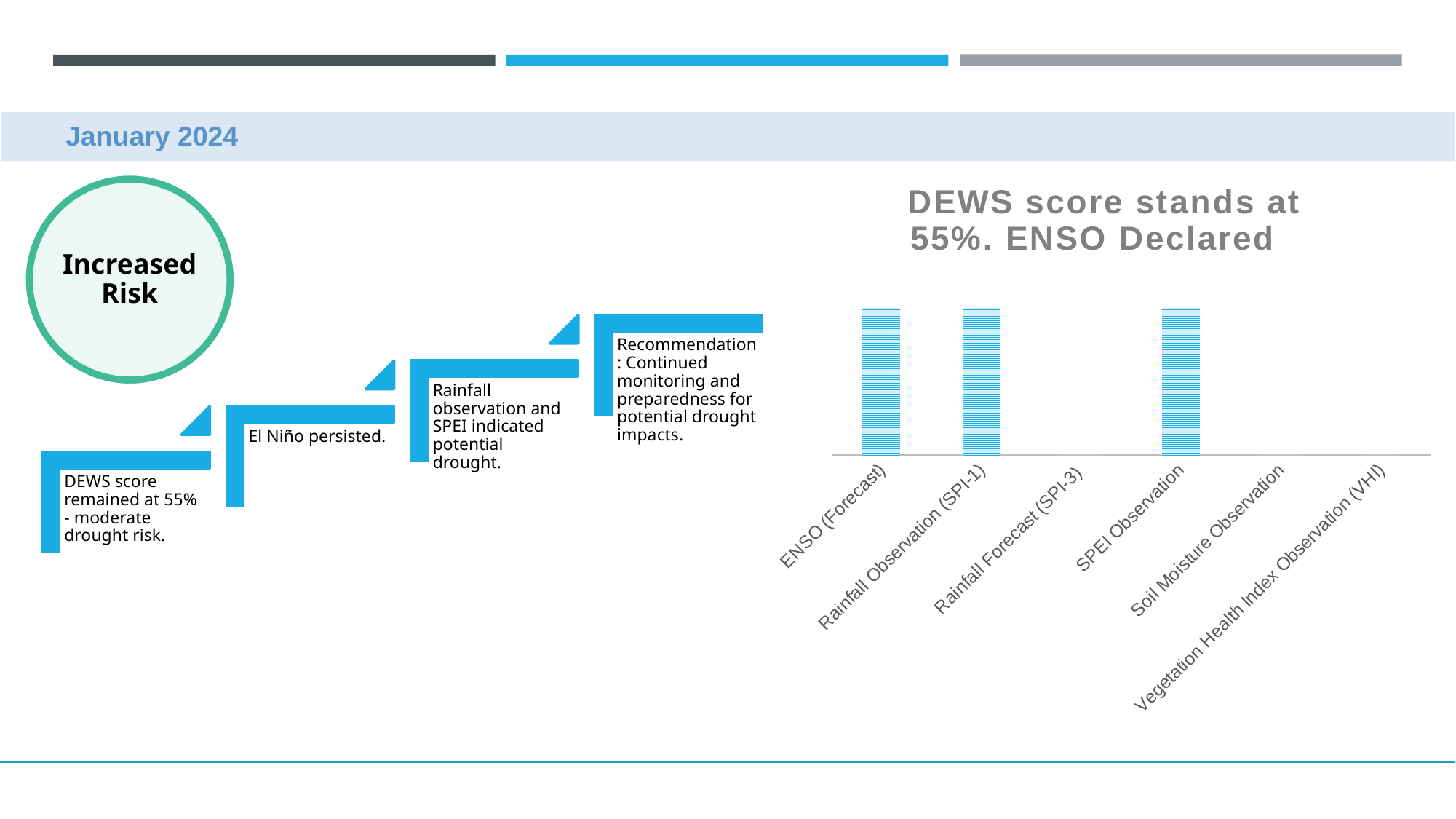
How many categories in the bar chart have a visible bar? 3 Which categories in the bar chart show no bar at all? Rainfall Forecast (SPI-3), Soil Moisture Observation, Vegetation Health Index Observation (VHI) In the bar chart, which is larger: Rainfall Observation (SPI-1) or Vegetation Health Index Observation (VHI)? Rainfall Observation (SPI-1) How many categories are listed on the x axis of the bar chart? 6 Which categories in the bar chart have a visible bar? ENSO (Forecast), Rainfall Observation (SPI-1), SPEI Observation In the bar chart, which is larger: ENSO (Forecast) or Rainfall Forecast (SPI-3)? ENSO (Forecast) What is the first category on the x axis of the bar chart? ENSO (Forecast) In the bar chart, which is larger: SPEI Observation or Soil Moisture Observation? SPEI Observation What kind of chart is shown on the right of the slide? bar chart